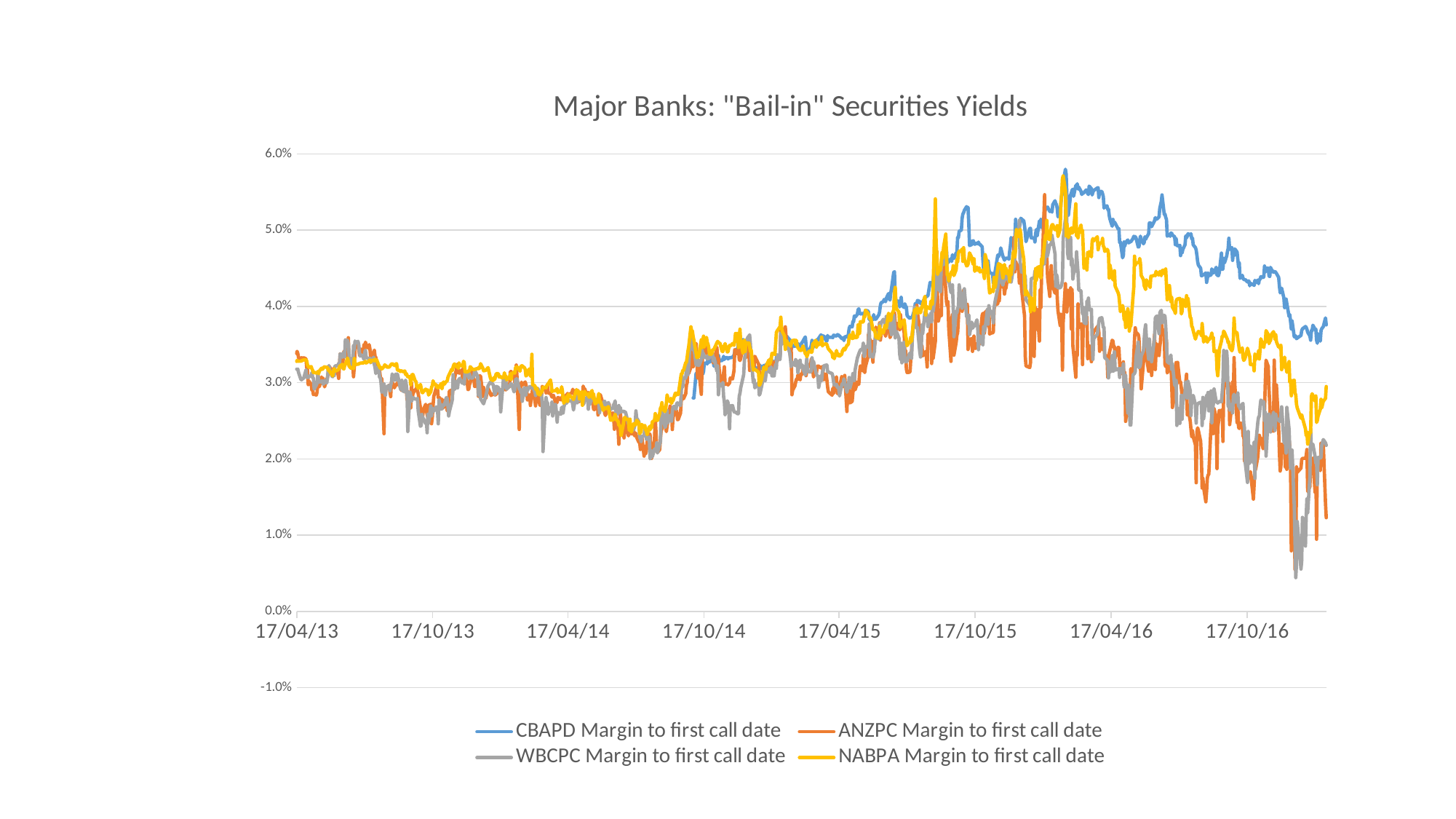
What kind of chart is shown on the slide? Line chart Does the CBAPD Margin to first call date series rise or fall between 17/04/16 and the end of the chart? fall How many date labels are shown on the x axis? 8 Which series is drawn in blue? CBAPD Margin to first call date At the right-hand end of the chart, which is higher: CBAPD Margin to first call date or ANZPC Margin to first call date? CBAPD Margin to first call date What is the title of the chart? Major Banks: "Bail-in" Securities Yields At the right-hand end of the chart, is the ANZPC Margin to first call date value greater or less than 2.0%? less Is the lowest value reached by the WBCPC Margin to first call date series greater or less than 1.0%? less How many series does the legend list? 4 Is the highest value reached by the CBAPD Margin to first call date series greater or less than 5.0%? greater Which series reaches the lowest point on the chart? WBCPC Margin to first call date